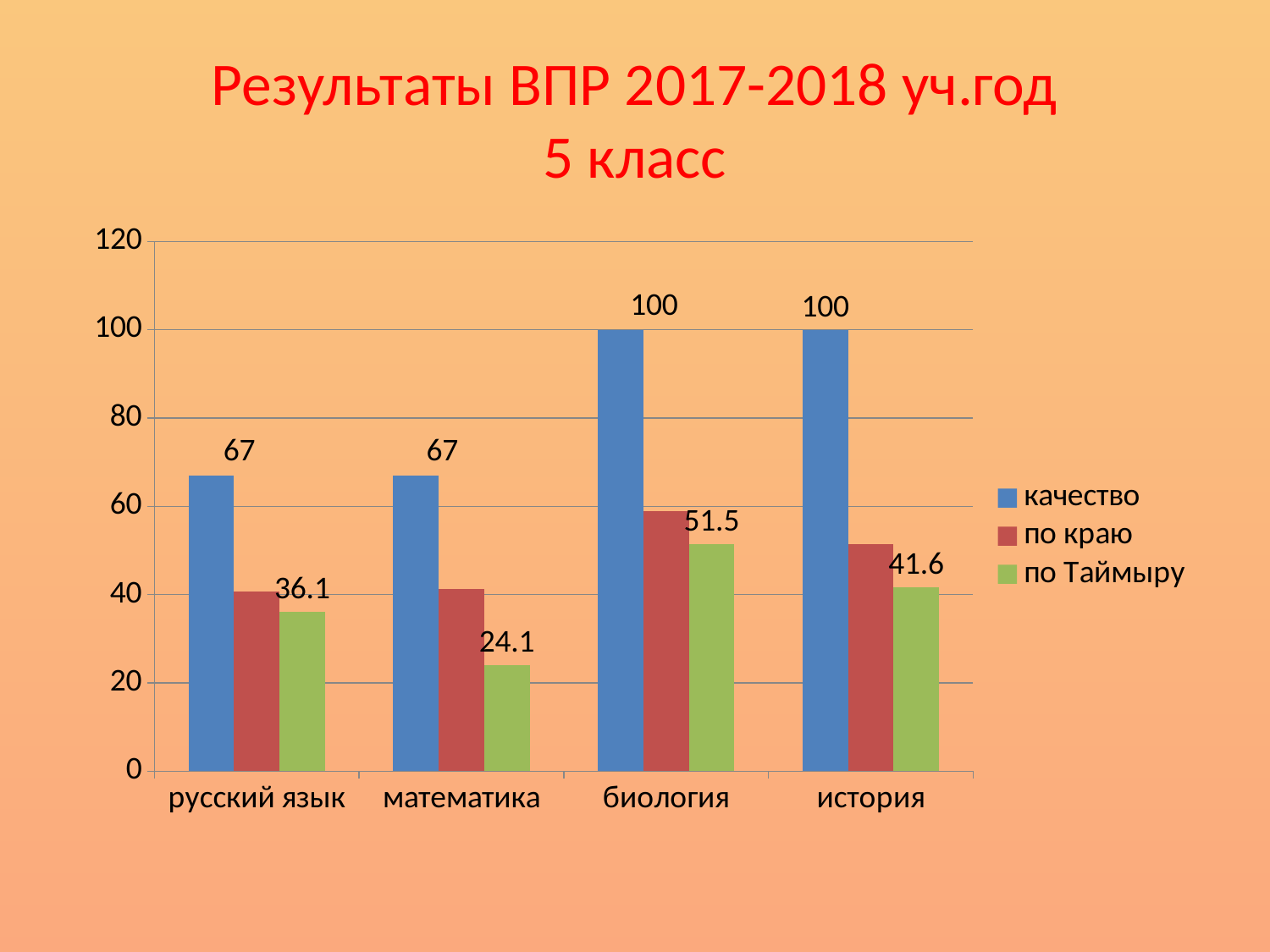
How many categories are shown on the x axis? 4 What is the value of по Таймыру for математика? 24.1 Is the value of по краю for биология greater or less than 40? greater What is the difference between качество and по Таймыру for история? 58.4 What is the difference between качество and по Таймыру for русский язык? 30.9 How many series does the legend list? 3 Which category has the lowest value for по Таймыру? математика What is the value of по Таймыру for биология? 51.5 What kind of chart is shown on the slide? bar chart What is the value of качество for биология? 100 Which is larger for по Таймыру: русский язык or история? история Which category has the highest value for по Таймыру? биология